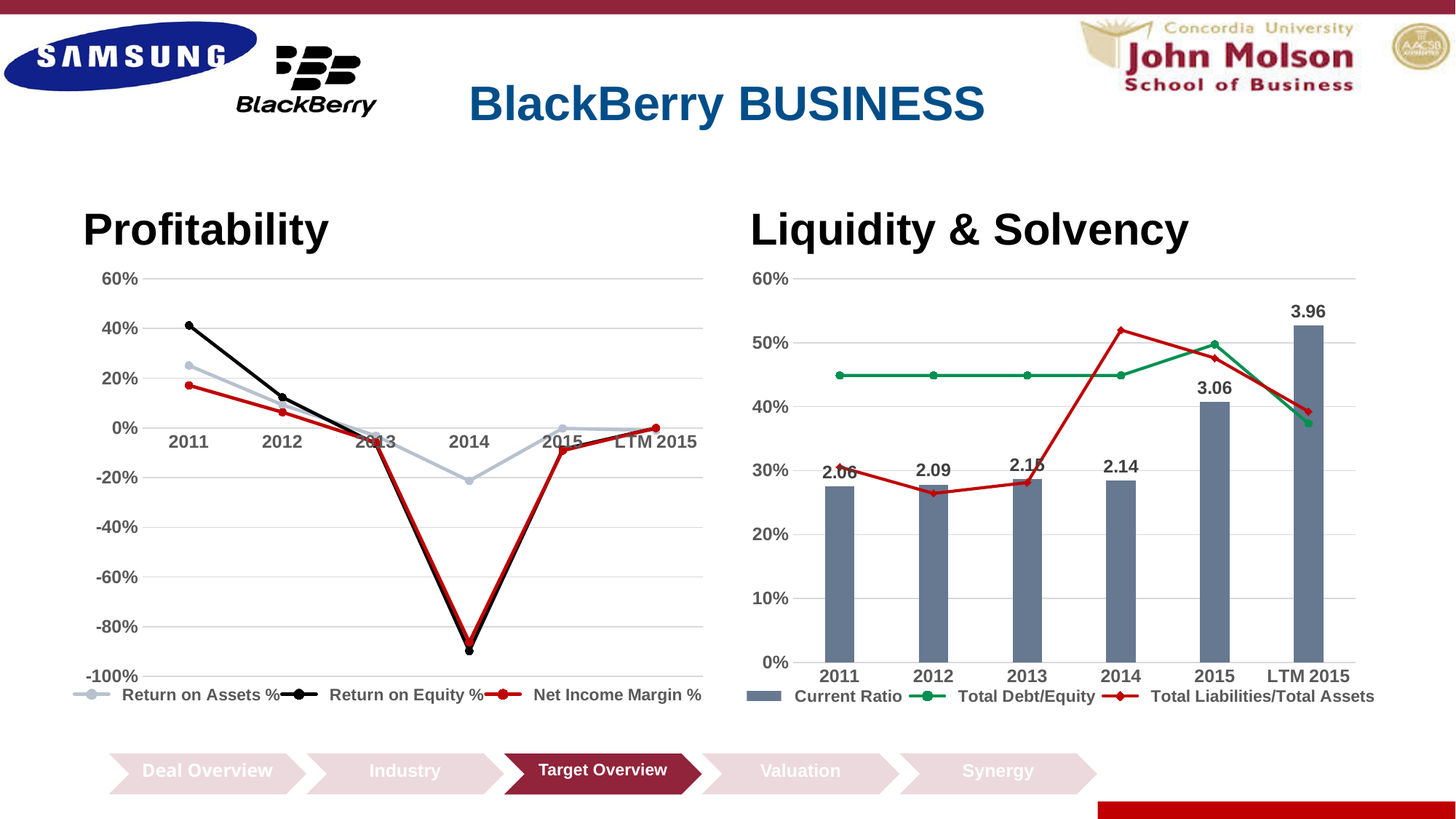
On the Liquidity & Solvency chart, which year has the highest Current Ratio? LTM 2015 On the Liquidity & Solvency chart, what is the Current Ratio for 2012? 2.09 On the Liquidity & Solvency chart, what is the Current Ratio for LTM 2015? 3.96 On the Profitability chart, what kind of chart is used? Line chart On the Profitability chart, in which year does Return on Equity % reach its lowest point? 2014 On the Liquidity & Solvency chart, how many series does the legend list? 3 On the Profitability chart, is the value of Return on Equity % in 2014 greater or less than -80%? less On the Profitability chart, how many years are shown on the x axis? 6 On the Profitability chart, how many series does the legend list? 3 On the Liquidity & Solvency chart, is the Current Ratio larger in 2013 or in 2014? 2013 On the Liquidity & Solvency chart, what is the difference between the Current Ratio in LTM 2015 and in 2015? 0.90 On the Liquidity & Solvency chart, which year has the lowest Current Ratio? 2011